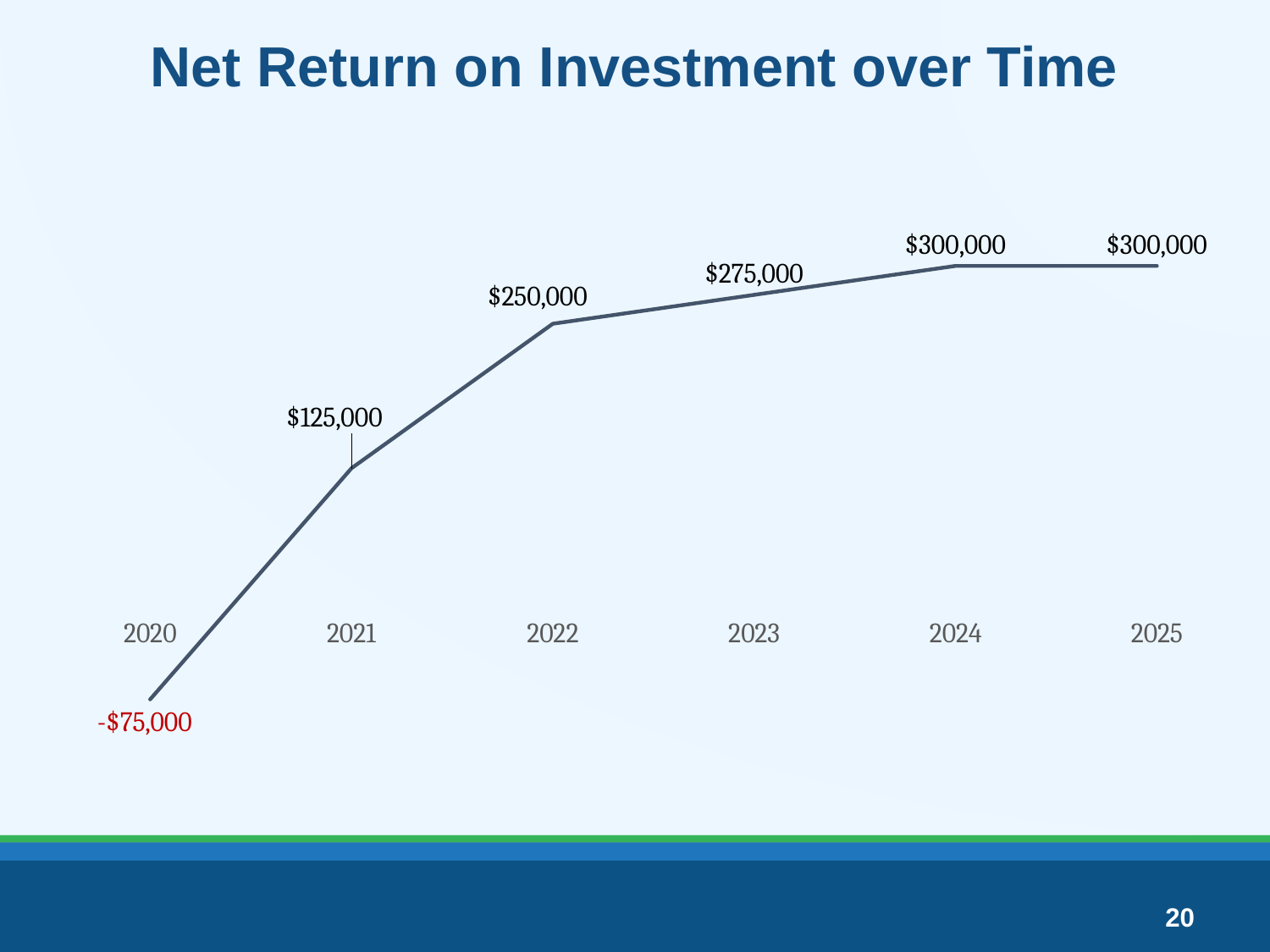
What kind of chart is shown on the slide? Line chart What is the net return on investment for 2020? -$75,000 What is the difference between the net return in 2022 and in 2021? $125,000 What is the net return on investment for 2023? $275,000 Do the values rise or fall from 2020 to 2024? Rise Which data label on the chart is shown in red? -$75,000 What is the difference between the net return in 2024 and in 2023? $25,000 What is the net return on investment for 2022? $250,000 Which year has the lowest net return on investment? 2020 Which is larger, the net return in 2021 or in 2023? 2023 What is the title of the chart? Net Return on Investment over Time How many years are plotted on the chart? 6